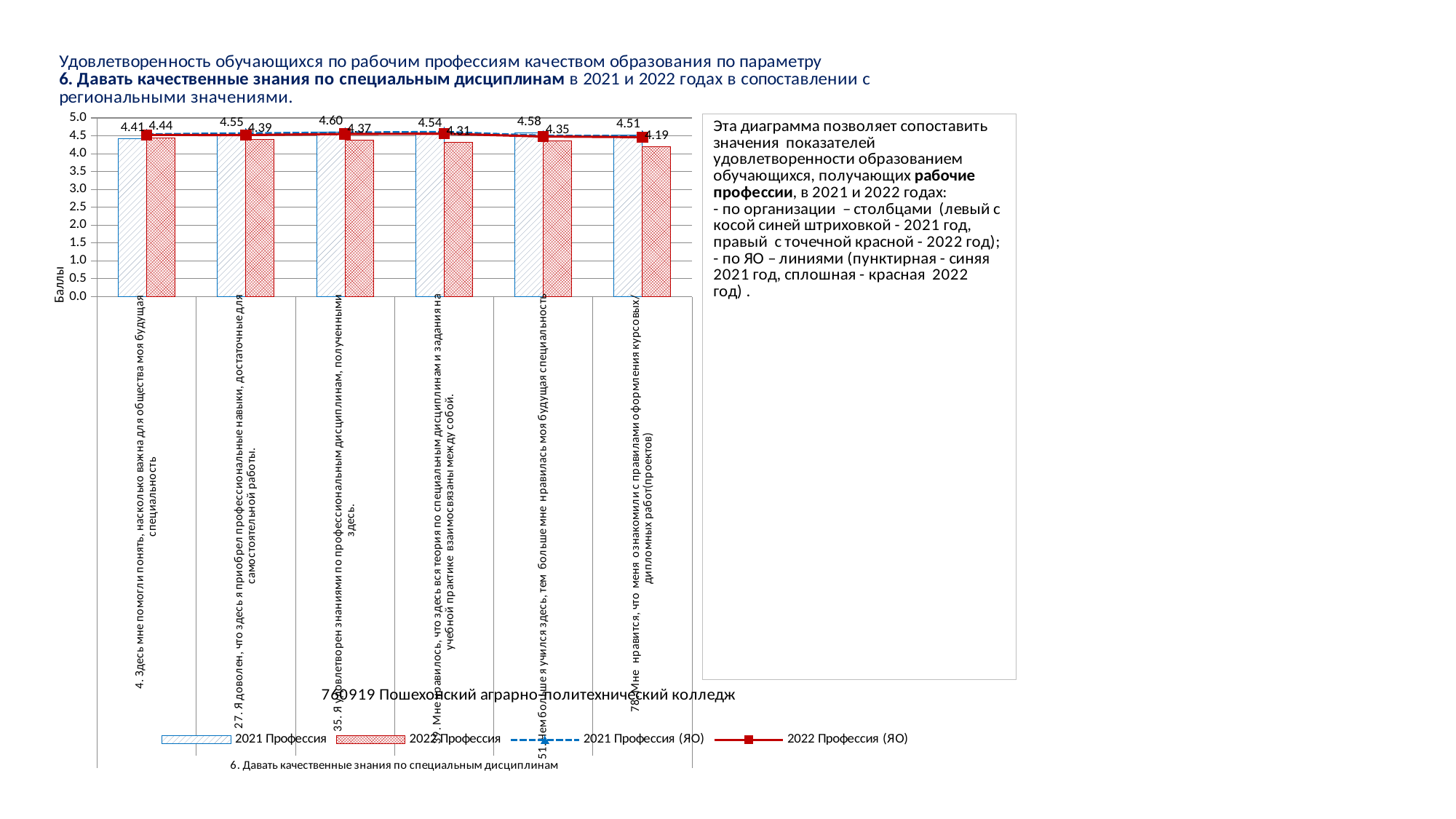
How many categories are shown on the x axis of the chart? 6 What is the 2021 Профессия value for category 4 (Здесь мне помогли понять, насколько важна для общества моя будущая специальность)? 4.41 Which category has the highest 2021 Профессия value? 35. Я удовлетворен знаниями по профессиональным дисциплинам, полученными здесь What is the difference between the 2021 Профессия and 2022 Профессия values for category 78? 0.32 What is the label of the vertical axis of the chart? Баллы What is the 2021 Профессия value for category 35 (Я удовлетворен знаниями по профессиональным дисциплинам, полученными здесь)? 4.60 For category 4, which is larger: the 2021 Профессия value or the 2022 Профессия value? 2022 Профессия Which category has the lowest 2022 Профессия value? 78. Мне нравится, что меня ознакомили с правилами оформления курсовых/дипломных работ(проектов) How many series does the chart legend list? 4 What is the 2022 Профессия value for category 78 (Мне нравится, что меня ознакомили с правилами оформления курсовых/дипломных работ)? 4.19 Which legend entry is drawn as a dashed blue line? 2021 Профессия (ЯО) What is the 2022 Профессия value for category 27 (Я доволен, что здесь я приобрел профессиональные навыки)? 4.39